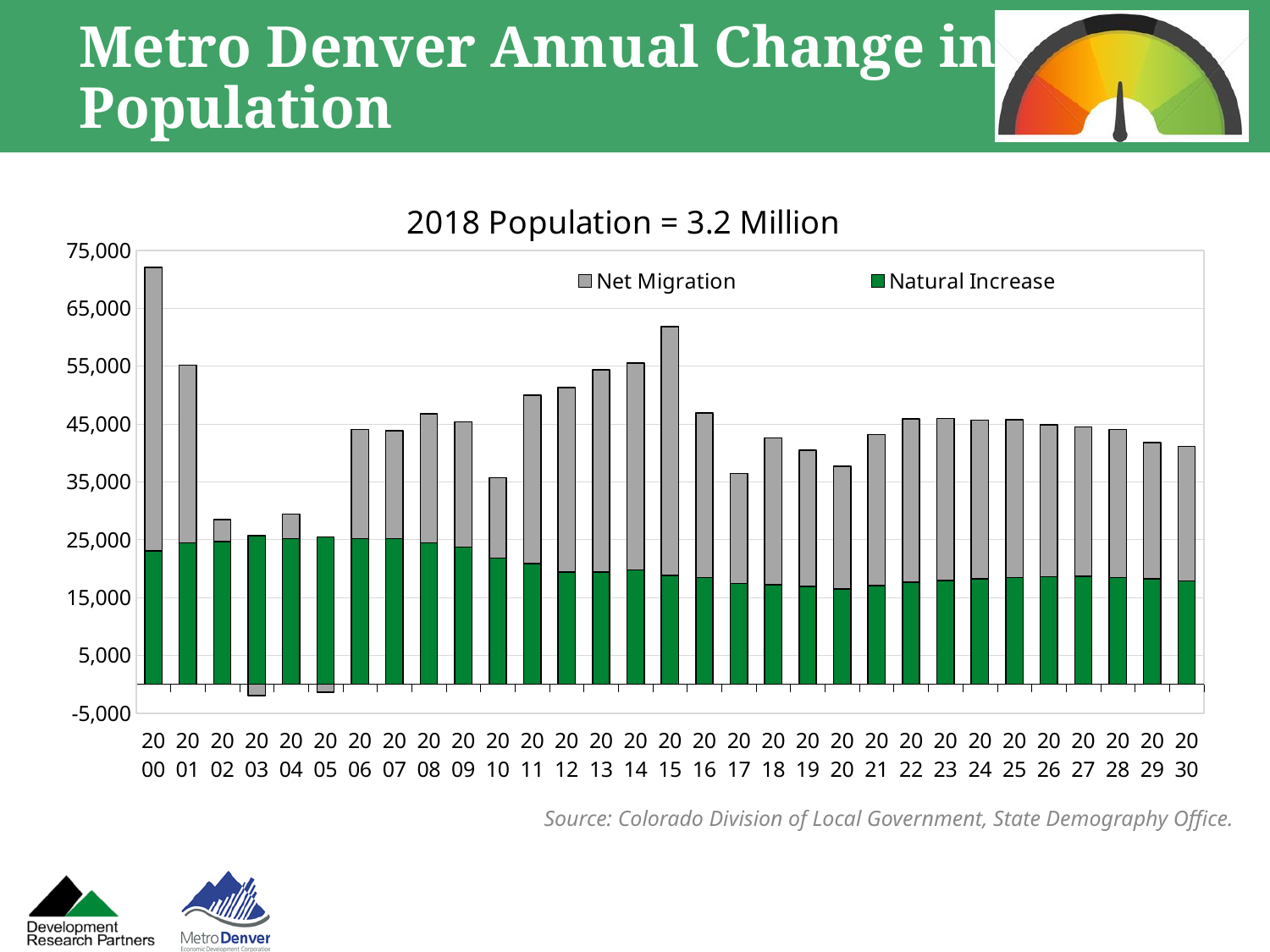
Is the total annual change for 2000 greater or less than 65,000? greater What are the two series named in the legend? Net Migration and Natural Increase Is the total annual change for 2017 greater or less than 45,000? less In which years is Net Migration shown as a negative value (below zero)? 2003 and 2005 What is the title shown above the chart? 2018 Population = 3.2 Million Is the Natural Increase value for 2020 greater or less than 25,000? less What kind of chart is shown on the slide? Stacked bar chart Which year has the tallest total bar? 2000 Which year has the larger total annual change, 2015 or 2016? 2015 How many years are shown along the x axis? 31 How many series does the legend list? 2